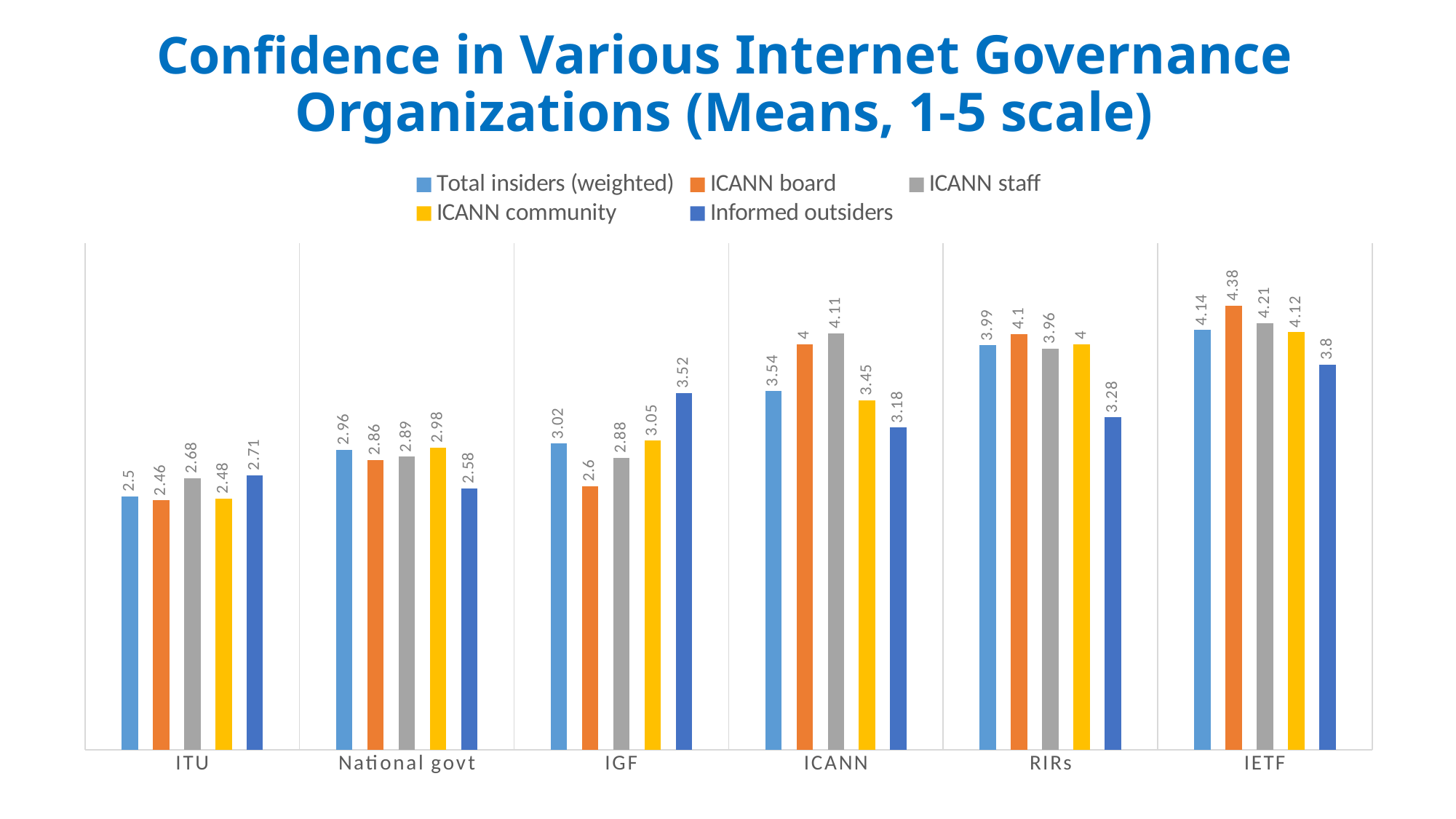
What is the value for Informed outsiders for IGF? 3.52 Which is larger for ICANN: the ICANN staff value or the Informed outsiders value? ICANN staff How many series does the legend list? 5 What is the title of the chart? Confidence in Various Internet Governance Organizations (Means, 1-5 scale) What is the value for ICANN staff for ICANN? 4.11 What kind of chart is shown on the slide? Bar chart Which organization has the highest value for Total insiders (weighted)? IETF Which organization has the lowest value for ICANN board? ITU How many organizations are shown on the x axis? 6 What is the value for ICANN board for IETF? 4.38 What is the value for ICANN community for ITU? 2.48 What is the difference between the ICANN board value for IETF and the ICANN board value for ITU? 1.92